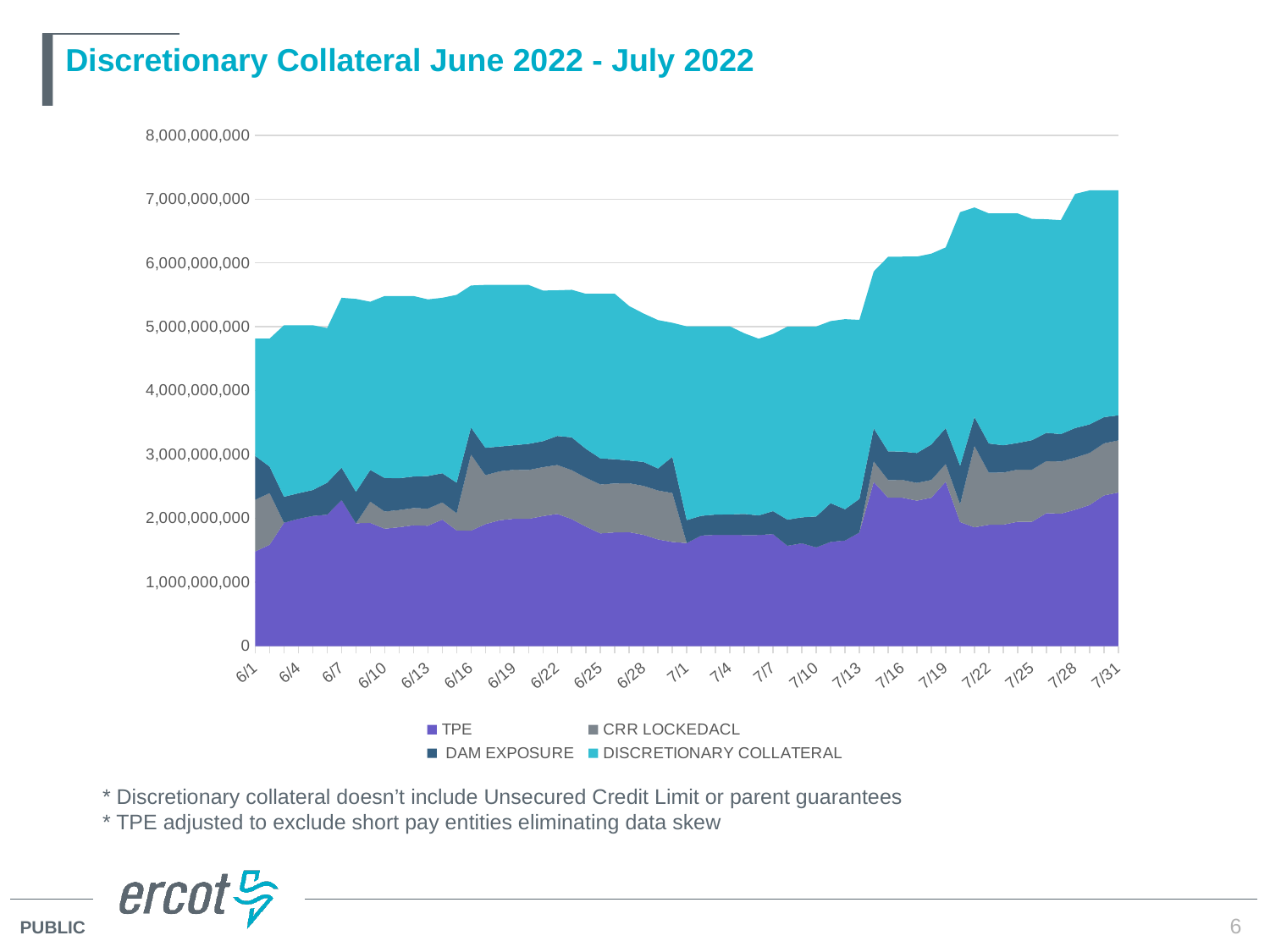
On 7/31, which is larger: the TPE value or the DISCRETIONARY COLLATERAL value? DISCRETIONARY COLLATERAL Is the total stacked value on 7/7 greater or less than 5,000,000,000? less Does the total stacked value rise or fall from 7/13 to 7/31? rise How many series does the legend list? 4 Which series is plotted at the bottom of the stack? TPE What is the title of the chart? Discretionary Collateral June 2022 - July 2022 Is the TPE value on 7/31 greater or less than 2,000,000,000? greater Is the total stacked value on 6/1 greater or less than 5,000,000,000? less What kind of chart is shown on the slide? Stacked area chart Which series contributes the largest amount to the stack on 7/31? DISCRETIONARY COLLATERAL